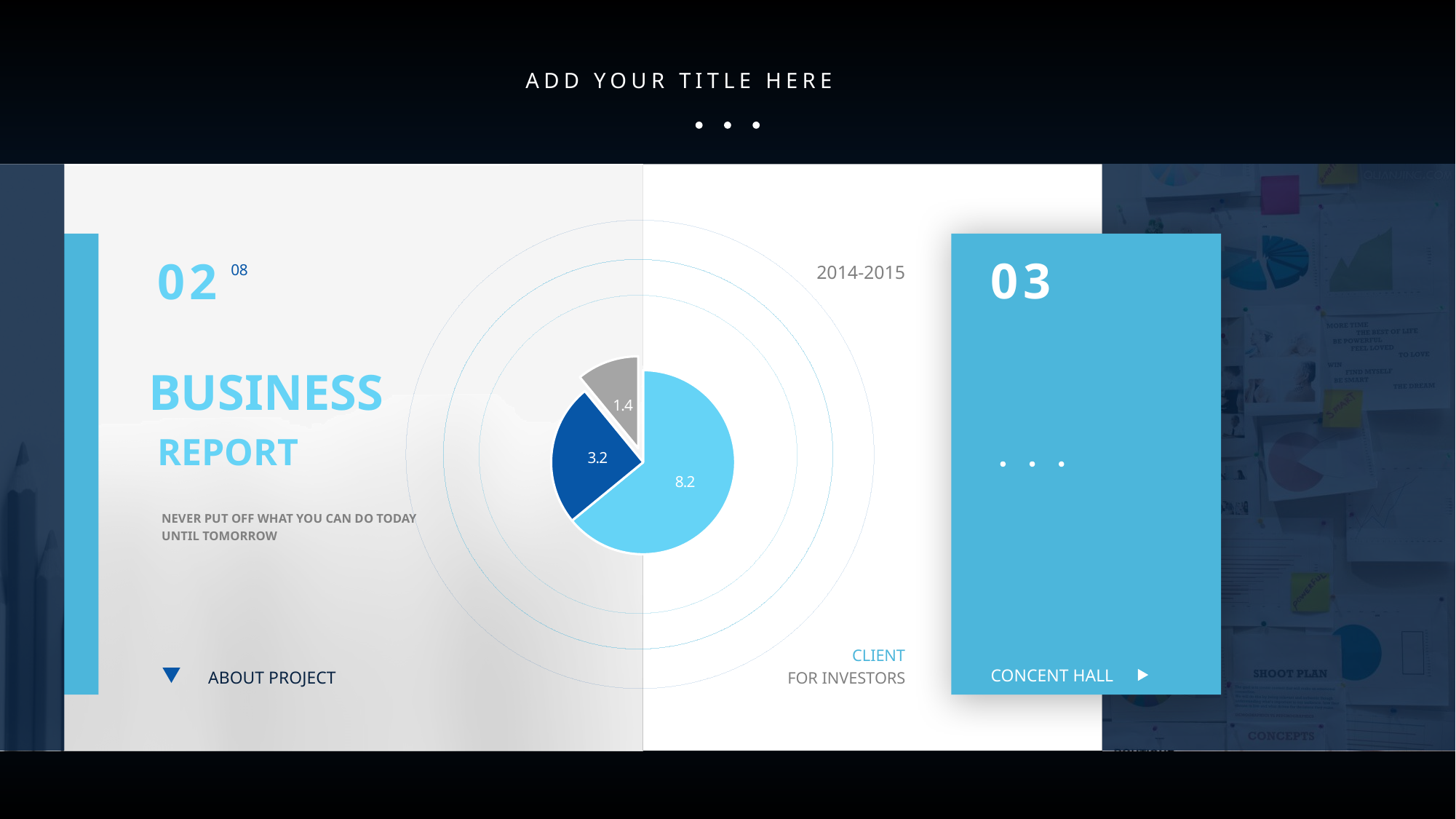
What is the smallest value shown in the pie chart? 1.4 What is the largest value shown in the pie chart? 8.2 What is the value of the gray slice of the pie chart? 1.4 How many slices does the pie chart have? 3 What is the difference between the dark blue slice (3.2) and the gray slice (1.4)? 1.8 What is the value of the dark blue slice of the pie chart? 3.2 What is the total of all three slice values in the pie chart? 12.8 What period label is shown next to the pie chart? 2014-2015 What is the difference between the light blue slice (8.2) and the dark blue slice (3.2)? 5.0 Which slice is larger, the dark blue one or the gray one? the dark blue one What kind of chart is shown on the slide? pie chart What is the value of the light blue slice of the pie chart? 8.2